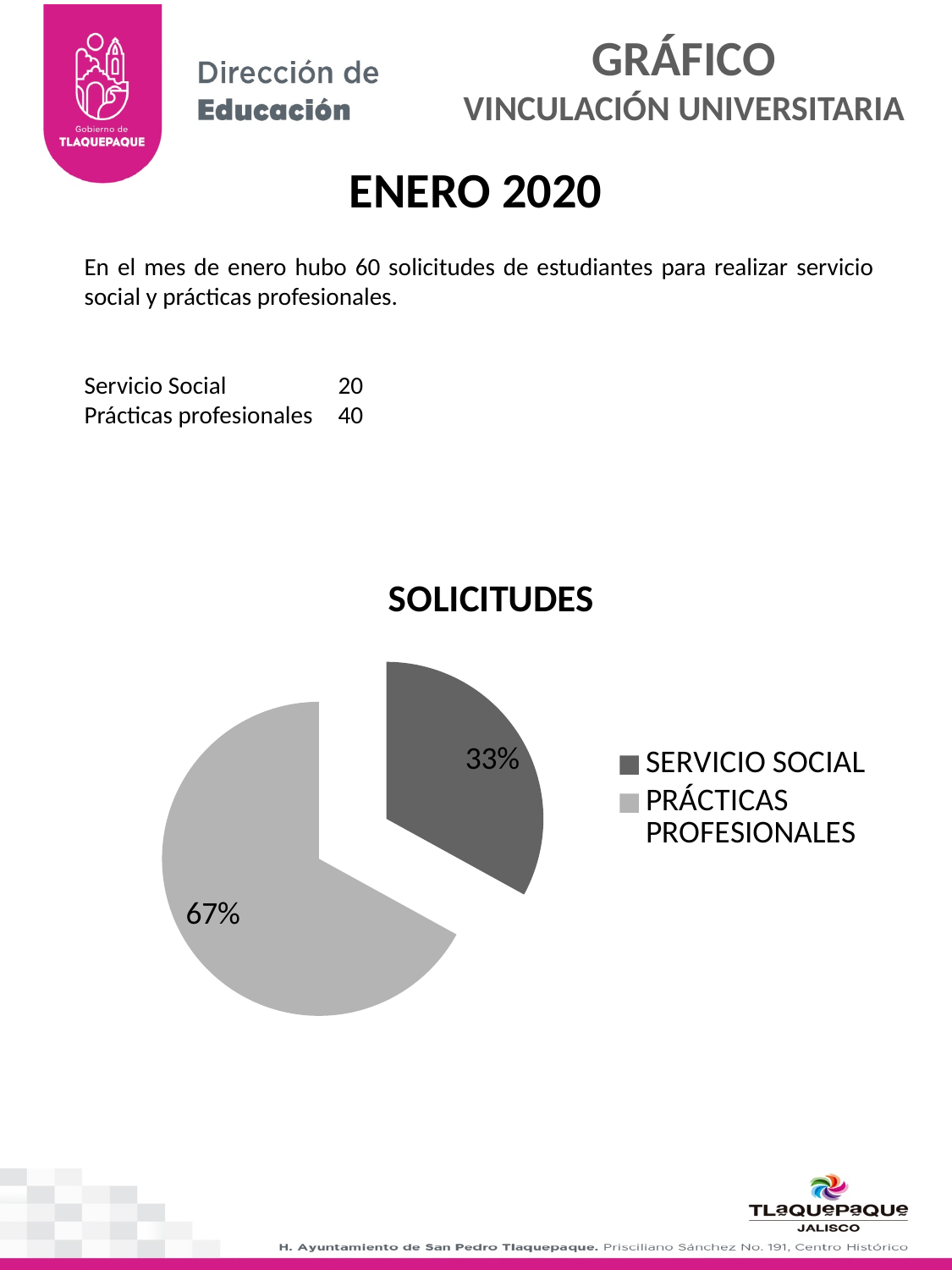
How many slices does the pie chart have? 2 What share of the pie does SERVICIO SOCIAL represent? 33% What is the title of the chart? SOLICITUDES What is the difference in percentage points between the PRÁCTICAS PROFESIONALES slice and the SERVICIO SOCIAL slice? 34% Which is larger, the share for SERVICIO SOCIAL or the share for PRÁCTICAS PROFESIONALES? PRÁCTICAS PROFESIONALES How many entries does the legend list? 2 Which slice of the pie is the largest? PRÁCTICAS PROFESIONALES Which slice of the pie is the smallest? SERVICIO SOCIAL Which slice is shown in dark grey? SERVICIO SOCIAL What share of the pie does PRÁCTICAS PROFESIONALES represent? 67% What kind of chart is shown on the slide? pie chart